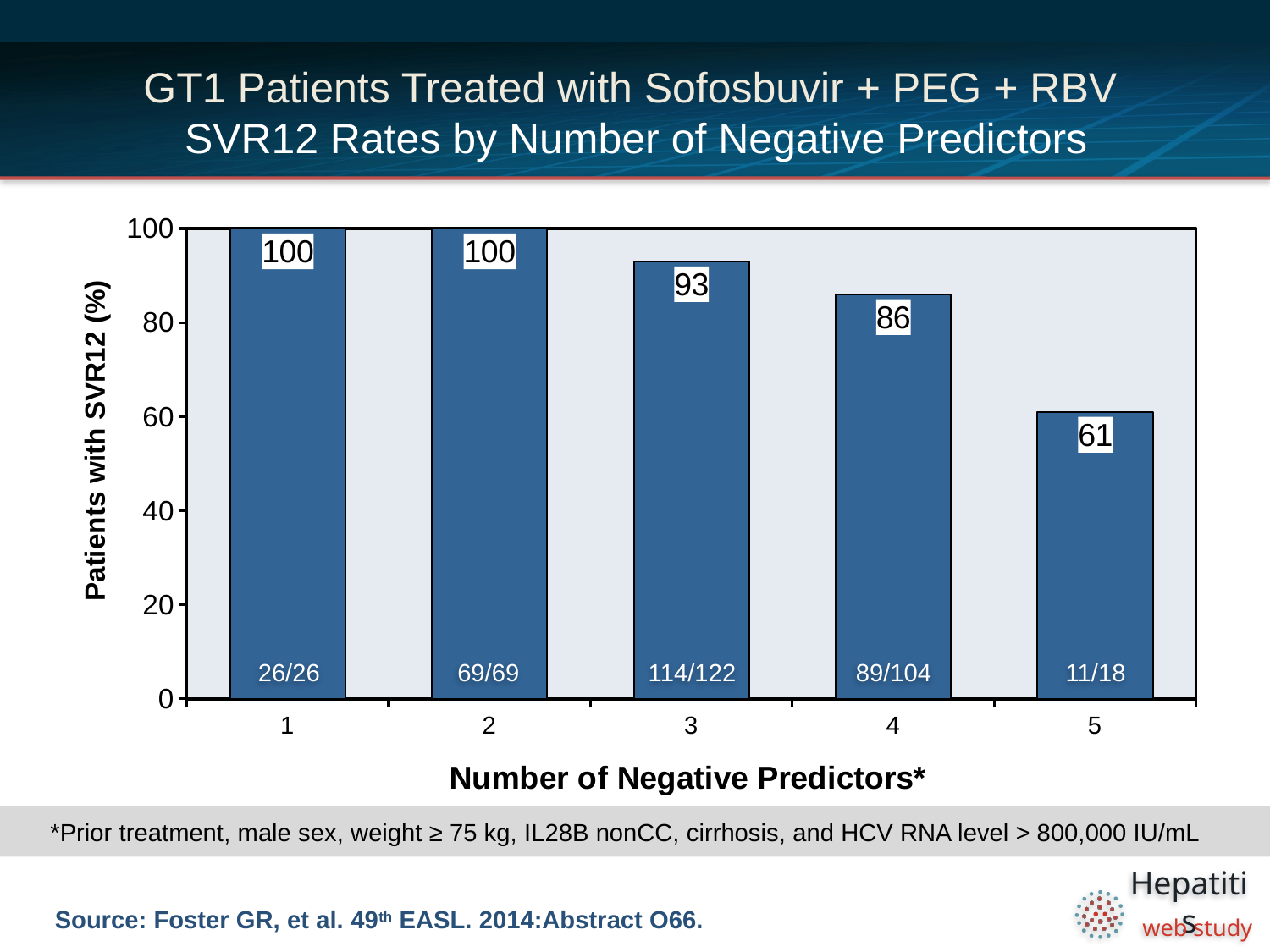
What is the difference in SVR12 rate between patients with 3 negative predictors and patients with 4 negative predictors? 7 Which number of negative predictors has the lowest SVR12 rate? 5 What fraction of patients is shown inside the bar for 3 negative predictors? 114/122 What is the difference in SVR12 rate between patients with 1 negative predictor and patients with 5 negative predictors? 39 Is the SVR12 rate for patients with 5 negative predictors greater or less than 80? less Do SVR12 rates rise or fall as the number of negative predictors increases? fall Which has a higher SVR12 rate: 4 negative predictors or 5 negative predictors? 4 negative predictors What is the SVR12 rate for patients with 4 negative predictors? 86 What kind of chart is shown on the slide? bar chart How many categories (numbers of negative predictors) are shown on the x axis? 5 What is the SVR12 rate for patients with 3 negative predictors? 93 What is the SVR12 rate for patients with 5 negative predictors? 61